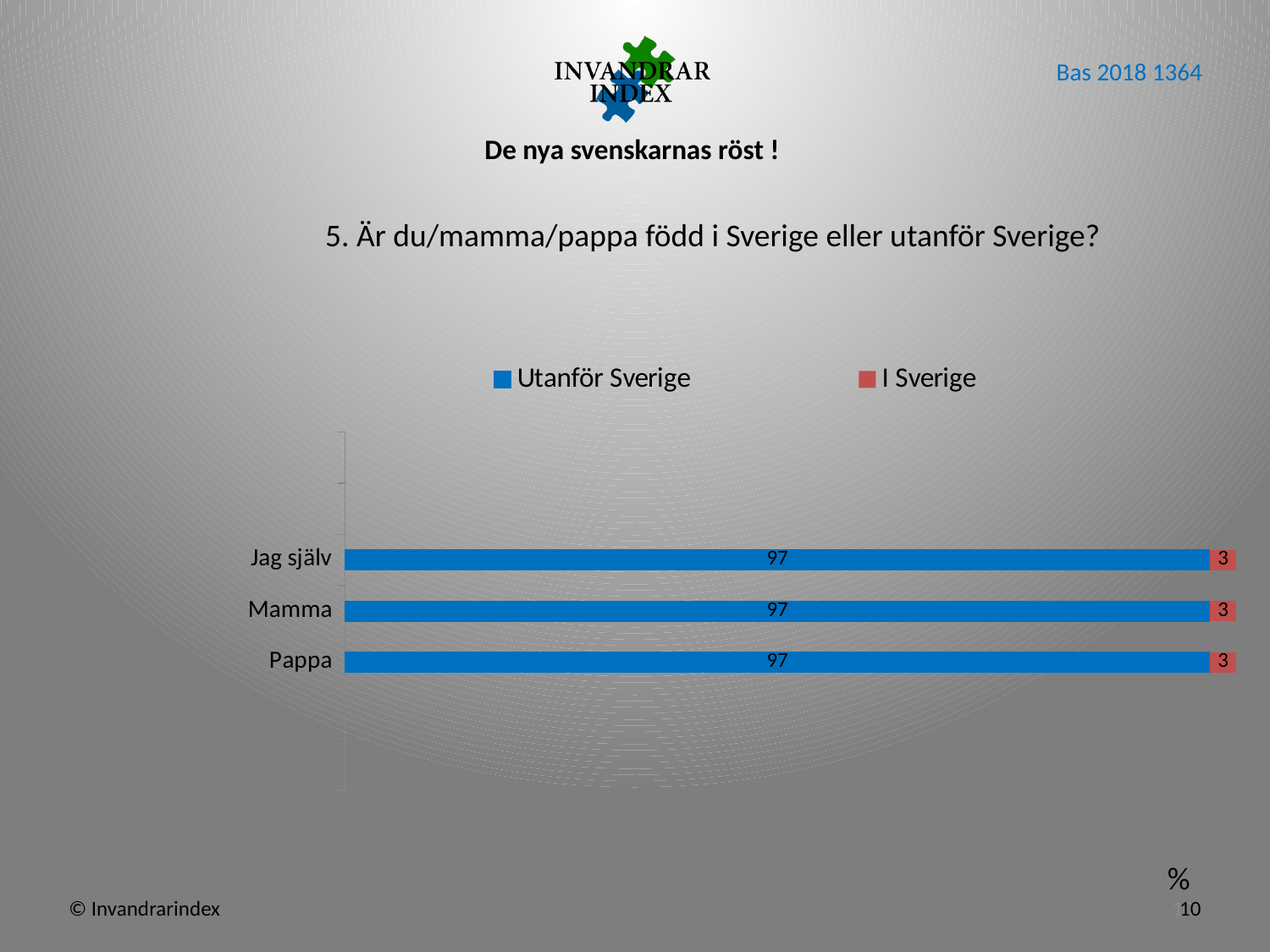
Which is larger for Mamma: "Utanför Sverige" or "I Sverige"? Utanför Sverige What colour represents the "I Sverige" series? Red What is the value for "Utanför Sverige" for Pappa? 97 What is the value for "I Sverige" for Mamma? 3 How many series does the legend list? 2 What is the total of the stacked bar for Jag själv? 100 What is the value for "Utanför Sverige" for Jag själv? 97 What kind of chart is shown on the slide? Stacked bar chart How many categories are shown on the chart? 3 What is the difference between the "Utanför Sverige" and "I Sverige" values for Pappa? 94 What is the value for "I Sverige" for Jag själv? 3 What is the title of the chart? 5. Är du/mamma/pappa född i Sverige eller utanför Sverige?